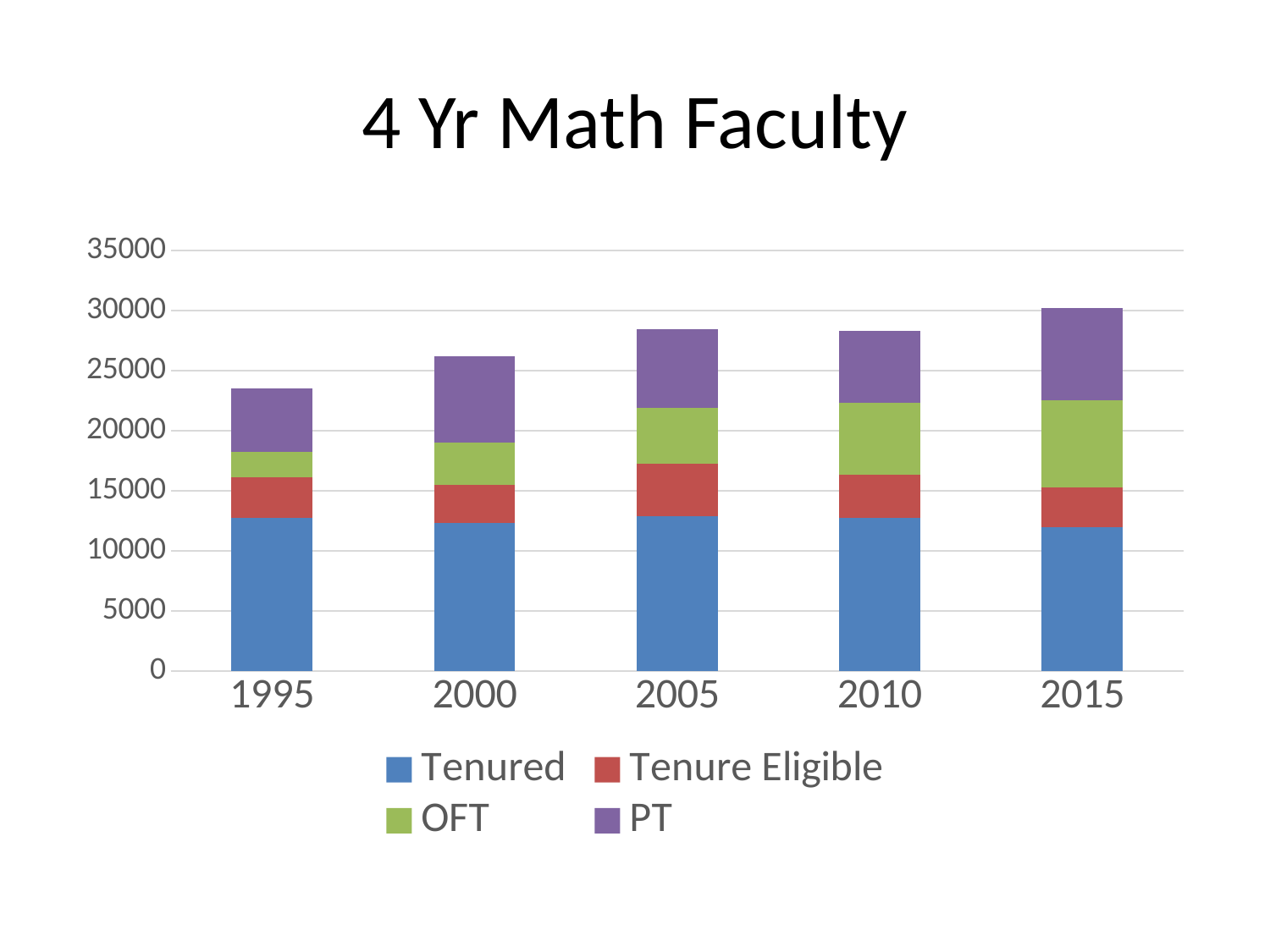
Which series is shown in purple in the legend? PT What is the title of the chart? 4 Yr Math Faculty How many years are shown on the x axis? 5 Is the Tenured value for 1995 greater or less than 10000? greater Is the total stacked bar for 1995 greater or less than 25000? less Is the total stacked bar for 2015 greater or less than 25000? greater Which year has the larger total stacked bar, 1995 or 2000? 2000 Which year has the tallest stacked bar? 2015 What kind of chart is shown on the slide? Stacked bar chart Which year has the shortest stacked bar? 1995 How many series does the legend list? 4